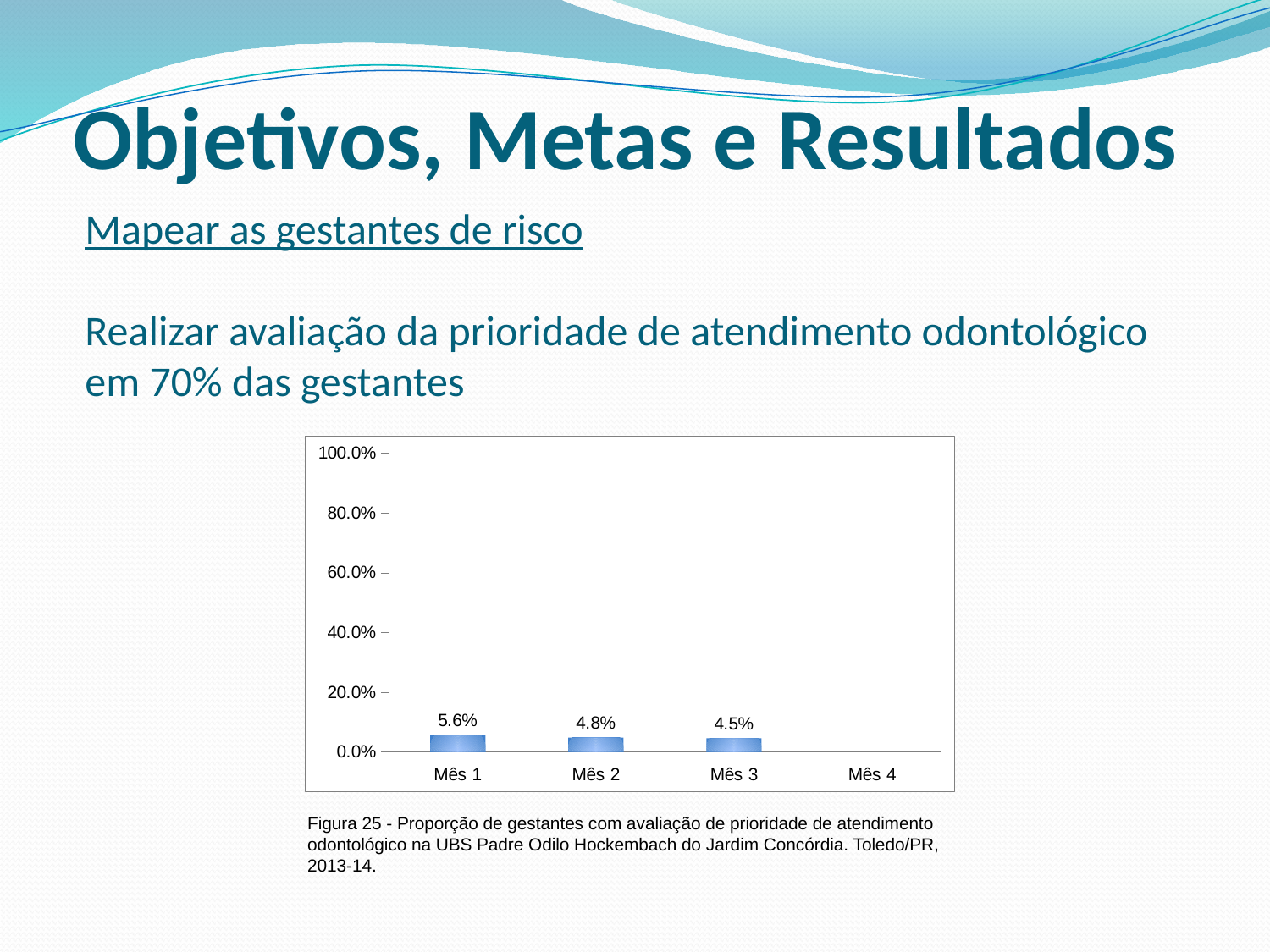
Which month has the highest value? Mês 1 What kind of chart is shown on the slide? bar chart What is the highest value shown on the y axis? 100.0% Is the value for Mês 1 greater or less than 20.0%? less What is the difference between the values for Mês 1 and Mês 3? 1.1% What is the value for Mês 3? 4.5% Do the values rise or fall from Mês 1 to Mês 3? fall How many categories are shown on the x axis? 4 What is the value for Mês 1? 5.6% Which is larger, the value for Mês 1 or the value for Mês 2? Mês 1 What is the value for Mês 2? 4.8% Which of the months with a labelled bar has the lowest value? Mês 3